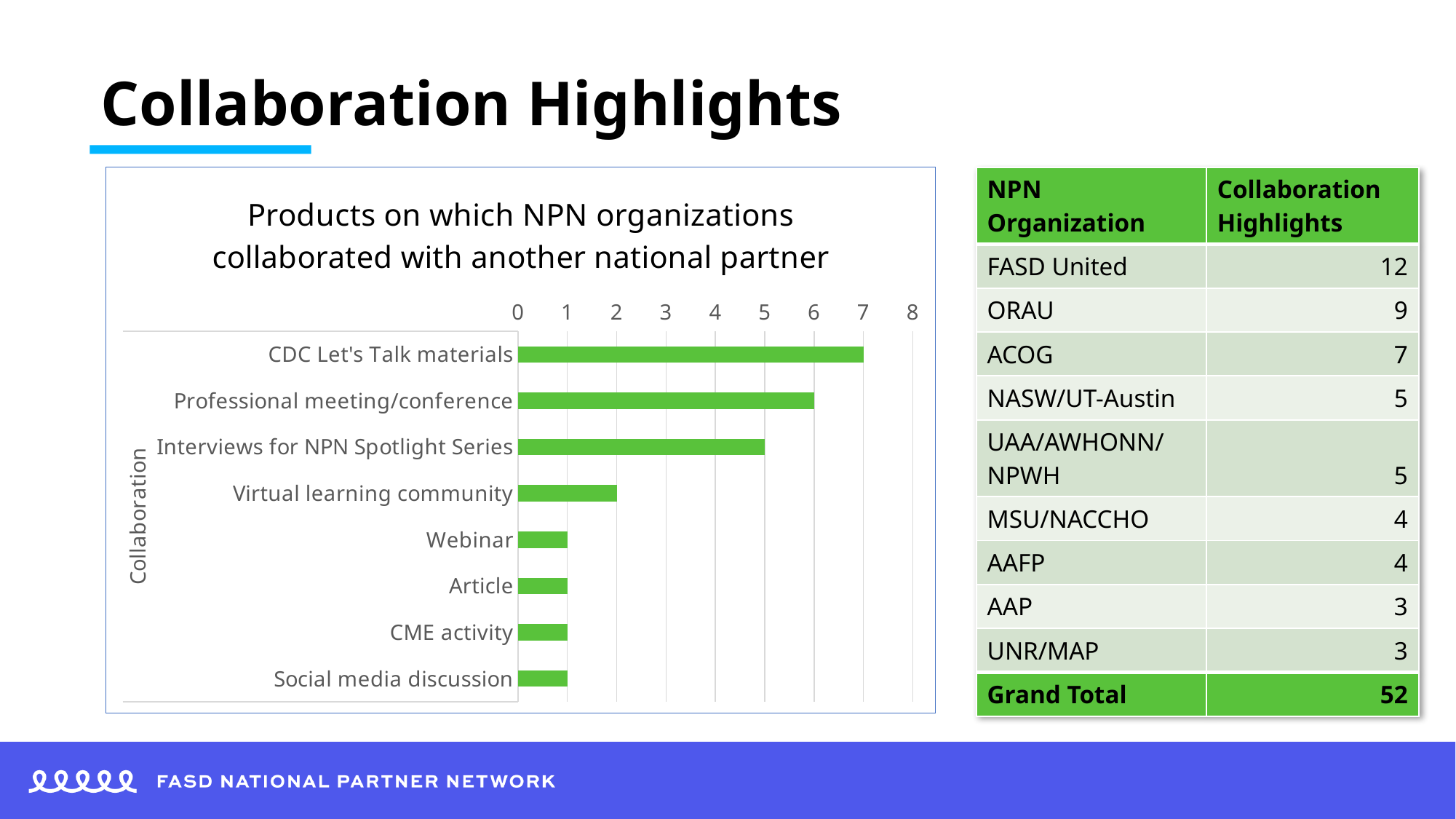
What is the value for Interviews for NPN Spotlight Series? 5 What is the value for Webinar? 1 How many categories are shown in the chart? 8 What kind of chart is shown on the slide? bar chart Is the value for Interviews for NPN Spotlight Series greater or less than 4? greater What is the label on the vertical axis of the chart? Collaboration What is the value for CDC Let's Talk materials? 7 Which category has the highest value? CDC Let's Talk materials Which is larger, the value for Professional meeting/conference or the value for Interviews for NPN Spotlight Series? Professional meeting/conference What is the difference between the values for CDC Let's Talk materials and Virtual learning community? 5 What is the value for Virtual learning community? 2 What is the value for Professional meeting/conference? 6